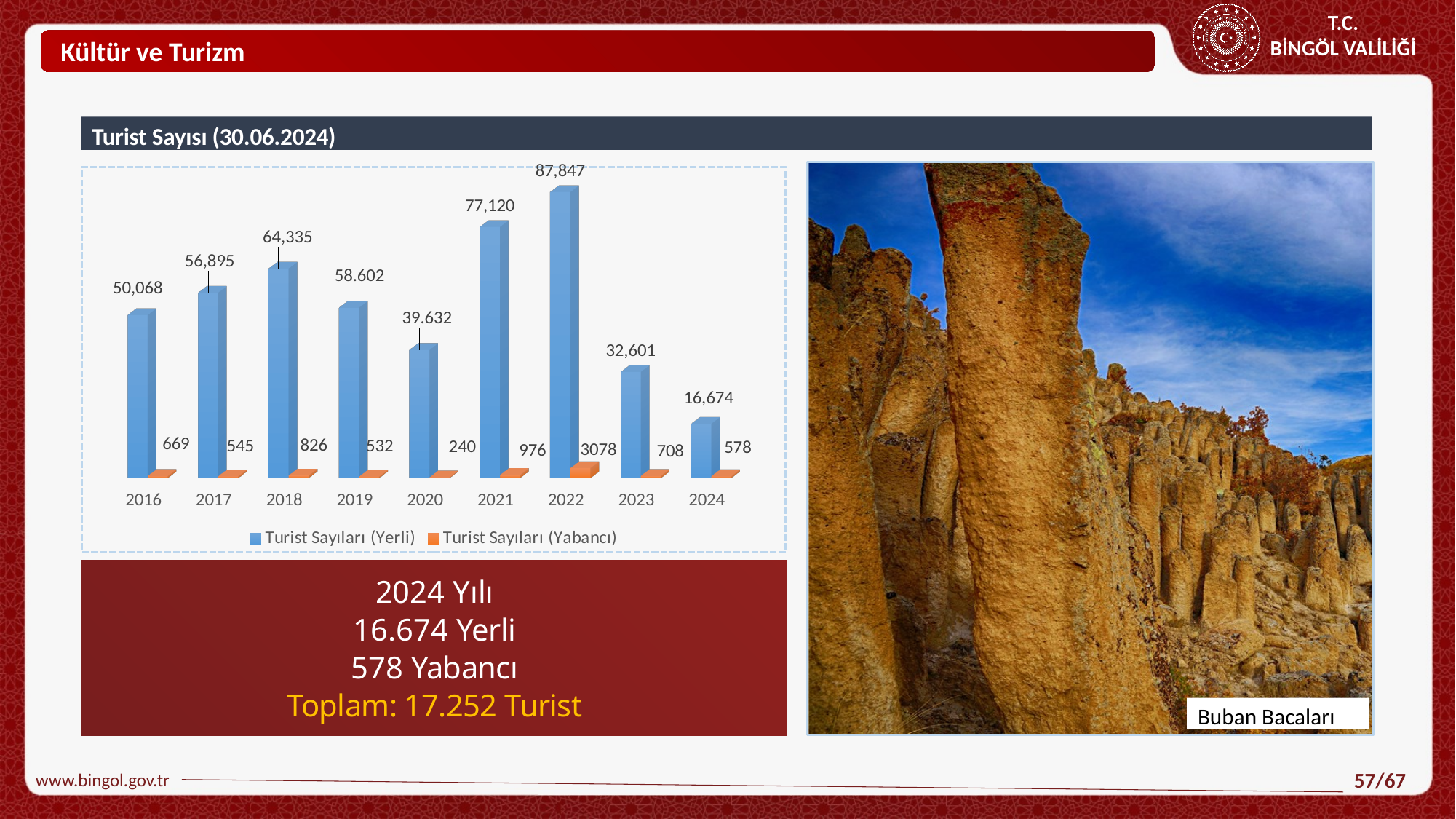
What is the difference between the Turist Sayıları (Yerli) values for 2022 and 2021? 10,727 What is the title of the chart? Turist Sayısı (30.06.2024) Which year has the highest value for Turist Sayıları (Yerli)? 2022 Which is larger, the Turist Sayıları (Yabancı) value for 2018 or for 2023? 2018 Which year has the lowest value for Turist Sayıları (Yerli)? 2024 What is the value for Turist Sayıları (Yerli) in 2022? 87,847 What is the value for Turist Sayıları (Yerli) in 2019? 58.602 What kind of chart is shown on the slide? Bar chart How many series does the chart legend list? 2 Which year has the lowest value for Turist Sayıları (Yabancı)? 2020 What is the value for Turist Sayıları (Yabancı) in 2020? 240 How many years are shown on the x axis of the chart? 9